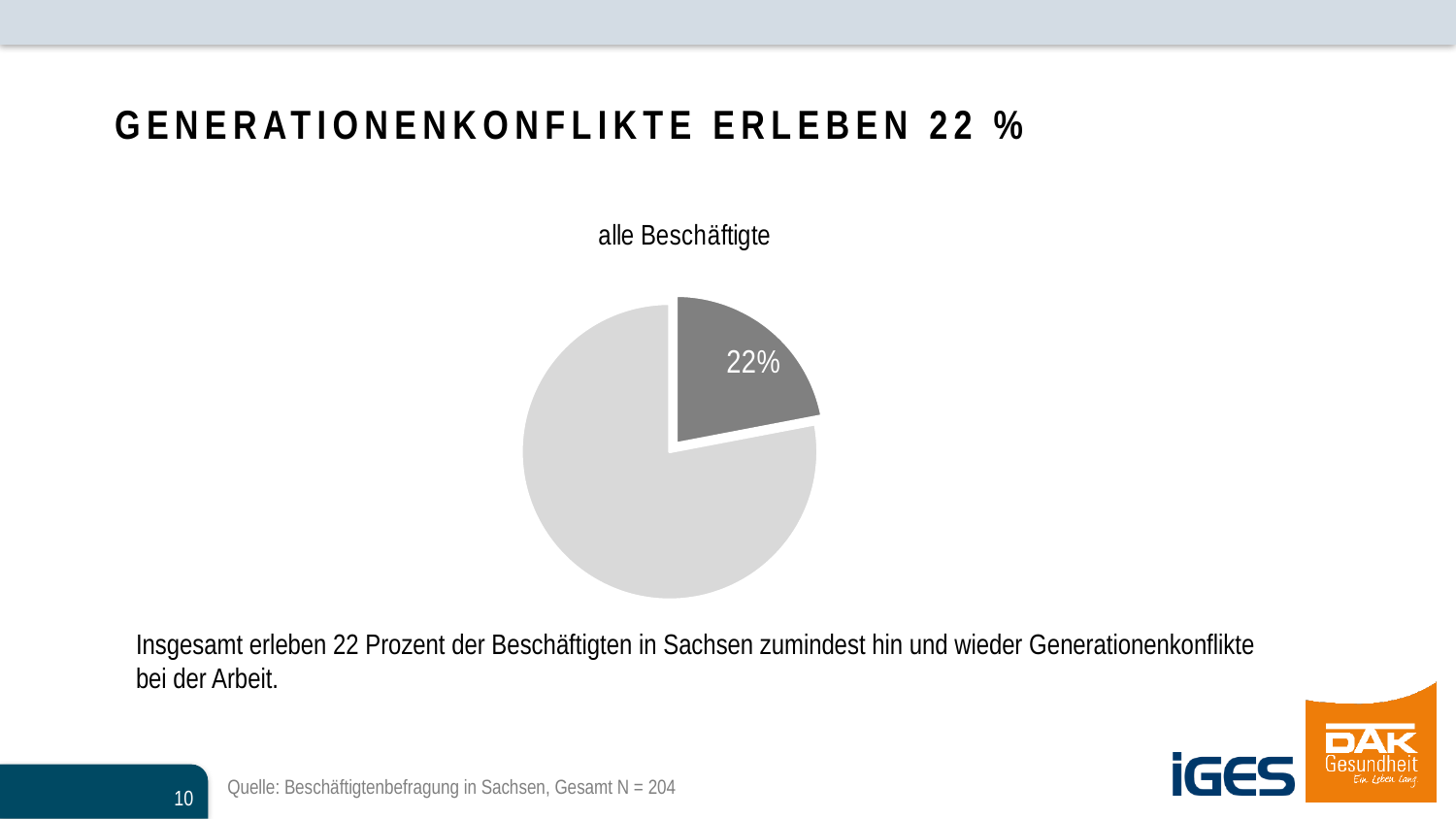
How many slices in the pie chart carry a printed data label? 1 What colour is the slice labelled 22%? dark grey Which slice of the pie chart is larger, the dark grey slice or the light grey slice? the light grey slice What kind of chart is shown on the slide? pie chart What percentage is printed on the dark grey slice of the pie chart? 22% How many slices does the pie chart have? 2 What share of all employees (alle Beschäftigte) experience generational conflicts according to the pie chart? 22% Which slice of the pie chart is the smallest? the dark grey slice (22%) What is the title of the pie chart? alle Beschäftigte